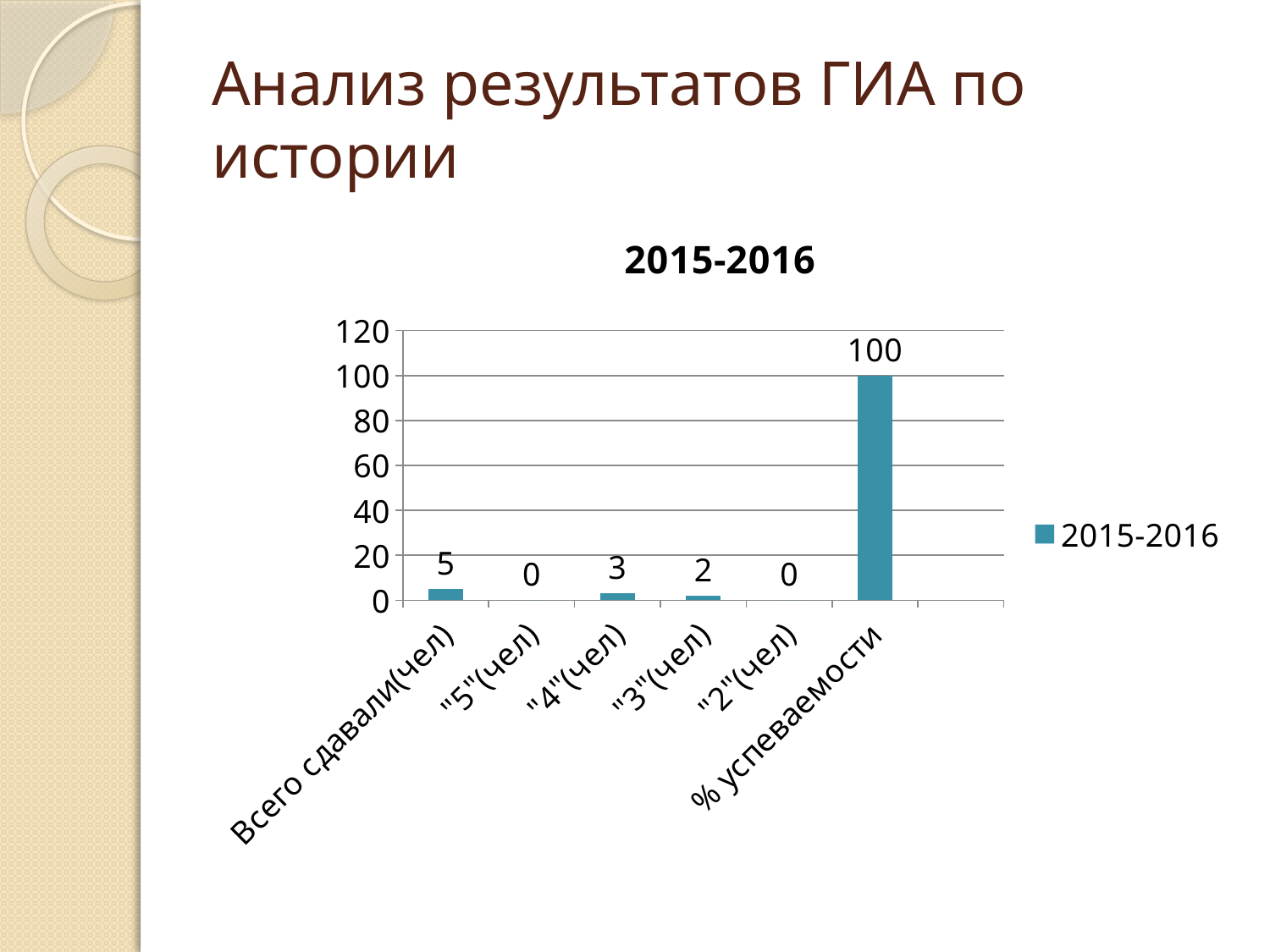
What kind of chart is shown? bar chart What is the value for "5"(чел)? 0 How many series does the legend list? 1 What is the value for "4"(чел)? 3 Which is larger, the value for "Всего сдавали(чел)" or the value for "4"(чел)? Всего сдавали(чел) What is the value for "3"(чел)? 2 What is the value for "% успеваемости"? 100 What is the difference between the values for "4"(чел) and "3"(чел)? 1 How many categories are shown on the x axis? 6 Which category has the highest value? % успеваемости What is the title of the chart? 2015-2016 What is the value for "Всего сдавали(чел)"? 5